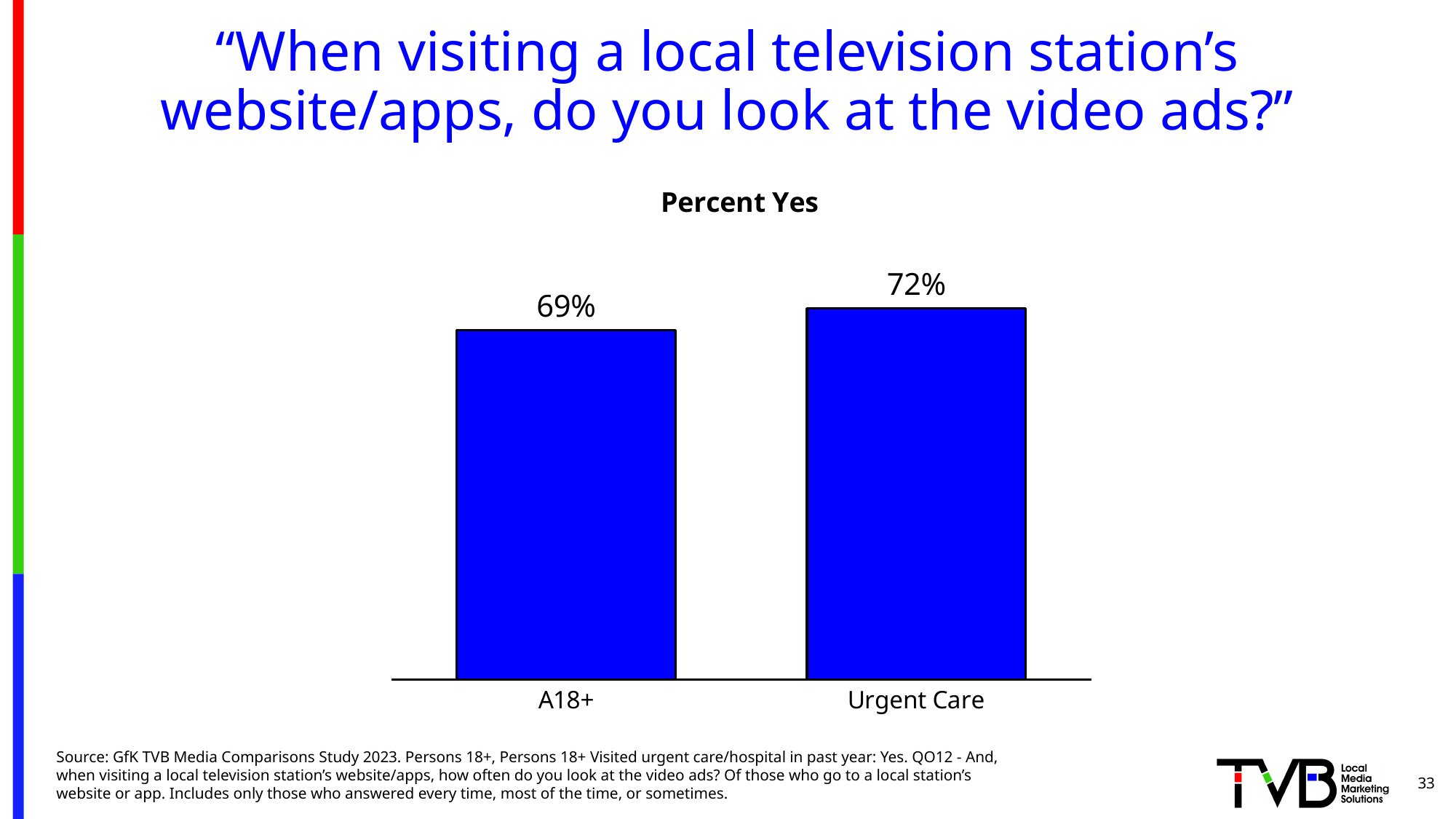
What is the Percent Yes value for A18+? 69% What colour are the bars in the chart? blue How many categories are shown in the chart? 2 What is the difference in Percent Yes between Urgent Care and A18+? 3% What is the title of the chart? Percent Yes Which category has the higher Percent Yes value? Urgent Care Is the Percent Yes value for A18+ larger or smaller than the value for Urgent Care? smaller What is the Percent Yes value for Urgent Care? 72% Which category has the lower Percent Yes value? A18+ What kind of chart is shown on the slide? bar chart